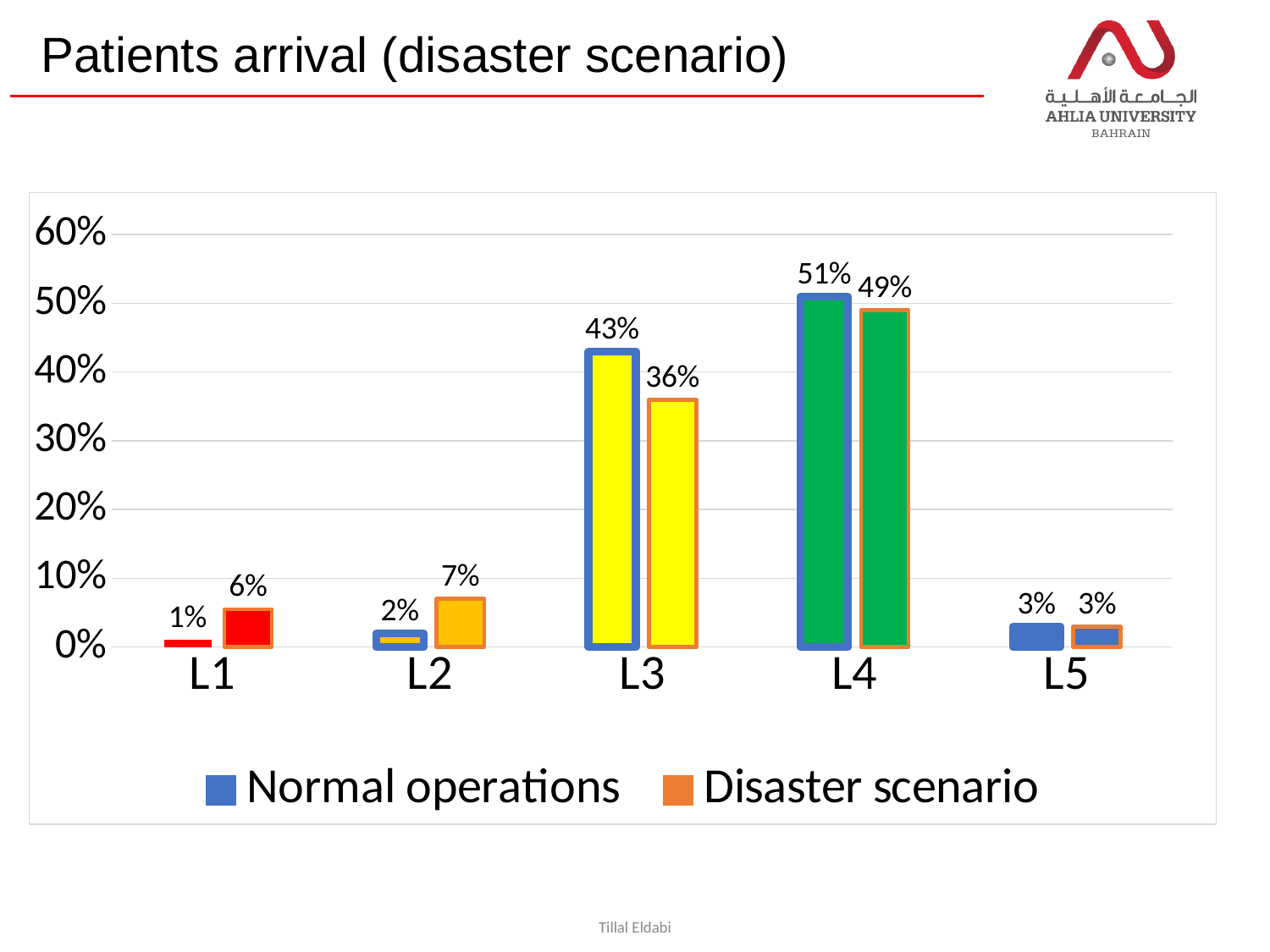
What kind of chart is shown on the slide? Bar chart What is the title of the slide containing the chart? Patients arrival (disaster scenario) How many categories are shown on the x axis? 5 What are the two series named in the legend? Normal operations and Disaster scenario Which category has the lowest Normal operations value? L1 What is the difference between the Normal operations and Disaster scenario values for L3? 7% What is the Disaster scenario value for L1? 6% For L2, which is larger: the Normal operations value or the Disaster scenario value? Disaster scenario What is the Normal operations value for L3? 43% How many series does the legend list? 2 Which category has the highest Normal operations value? L4 What is the Disaster scenario value for L4? 49%